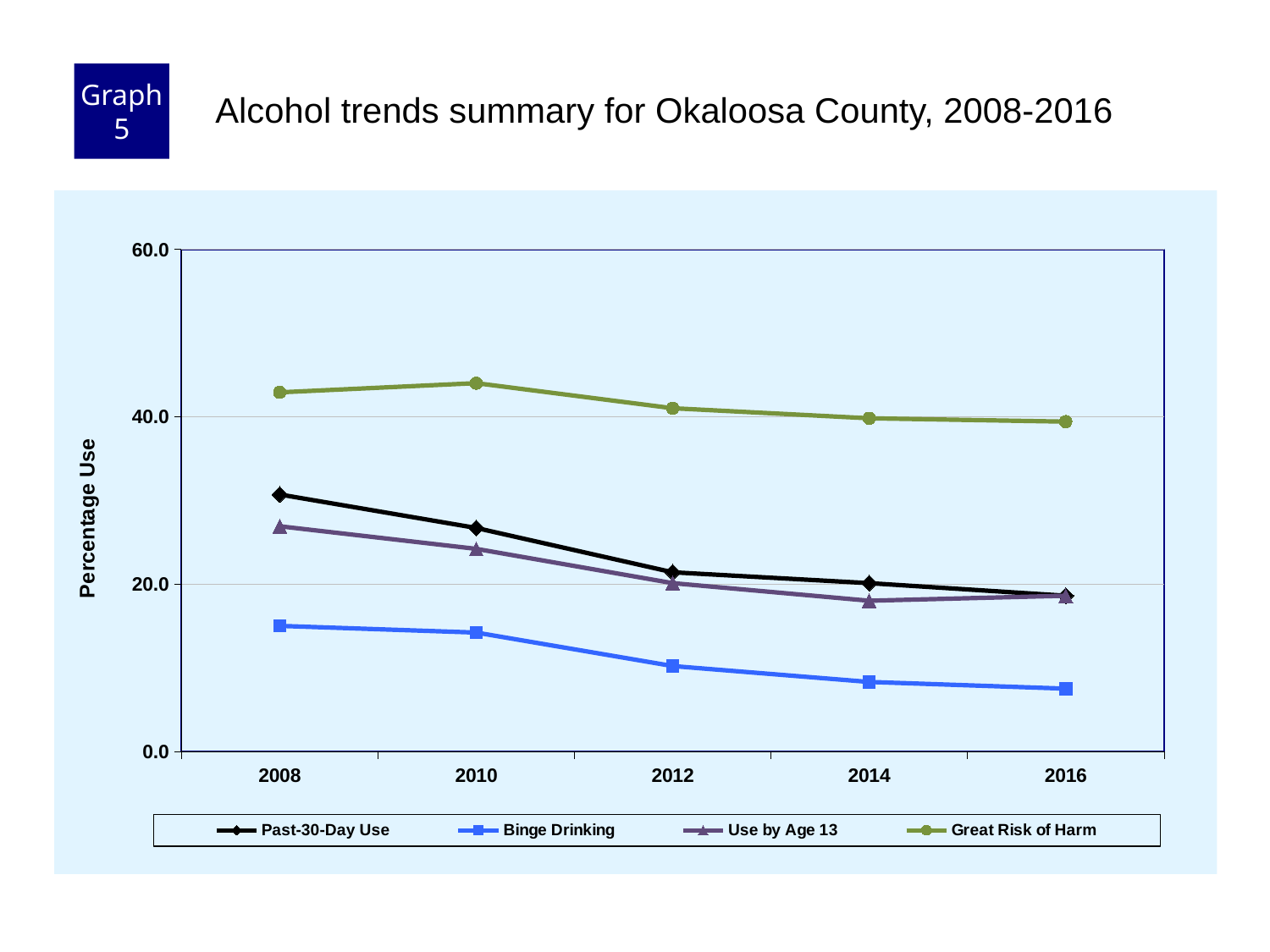
Is the value for Past-30-Day Use in 2008 greater or less than 20.0? greater Is the value for Binge Drinking in 2016 greater or less than 20.0? less Which series has the highest value in 2008? Great Risk of Harm In 2008, which is larger: Past-30-Day Use or Use by Age 13? Past-30-Day Use How many series does the legend list? 4 How many years are plotted along the x axis? 5 Is the value for Great Risk of Harm in 2008 greater or less than 40.0? greater Which series has the lowest value in 2016? Binge Drinking What kind of chart is shown on the slide? Line chart Does Binge Drinking rise or fall from 2008 to 2016? Fall What is the label on the y axis? Percentage Use What is the title of the slide's chart? Alcohol trends summary for Okaloosa County, 2008-2016